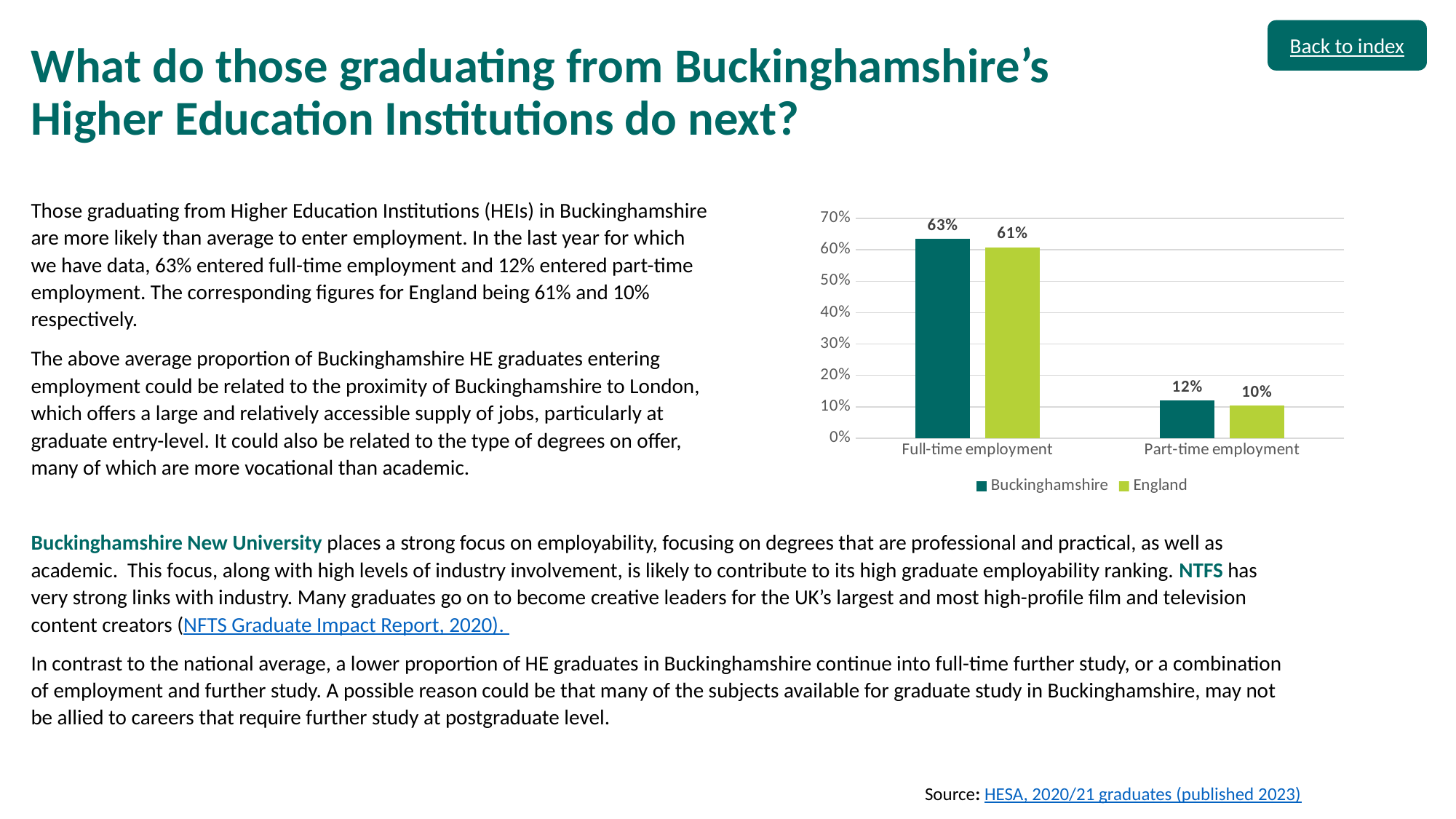
What is the difference between the Buckinghamshire and England values for Part-time employment? 2% What is the value for Buckinghamshire in the Full-time employment category? 63% Is the value for Buckinghamshire in Full-time employment greater or less than 60%? greater Which category has the lowest value for England? Part-time employment How many categories are shown on the x axis of the chart? 2 What is the value for Buckinghamshire in the Part-time employment category? 12% How many series does the chart's legend list? 2 What is the difference between the Buckinghamshire and England values for Full-time employment? 2% Which series has the higher value for Full-time employment, Buckinghamshire or England? Buckinghamshire What kind of chart is shown on the slide? Bar chart What is the value for England in the Part-time employment category? 10% What is the value for England in the Full-time employment category? 61%